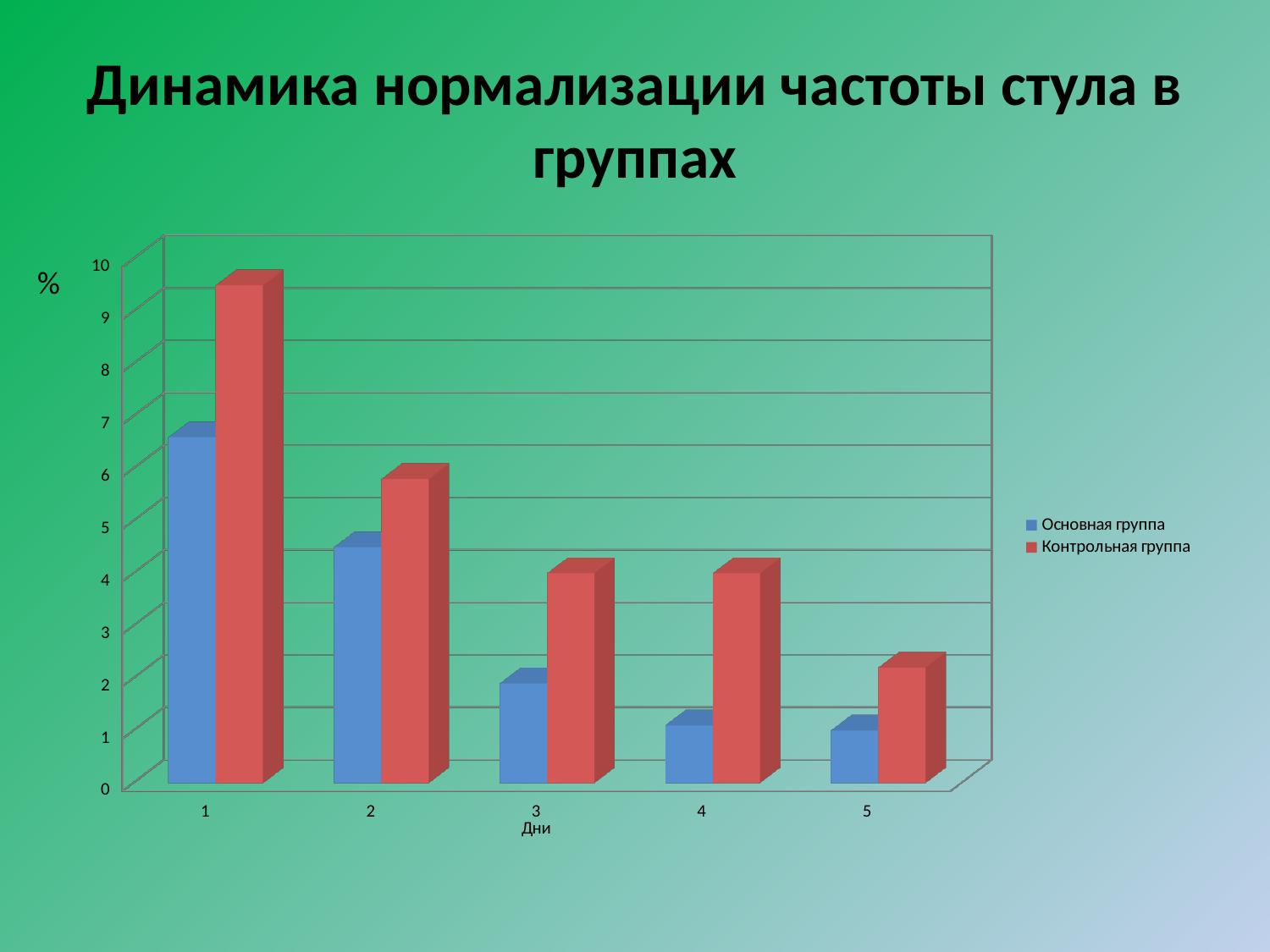
Is the value for Основная группа on day 3 greater or less than 3? less What is the title of the x axis? Дни Which series is shown in red in the legend? Контрольная группа On day 3, which series has the larger value, Основная группа or Контрольная группа? Контрольная группа What kind of chart is shown on the slide? bar chart How many series does the legend list? 2 Is the value for Контрольная группа on day 1 greater or less than 8? greater On which day is the value for Контрольная группа lowest? 5 Is the value for Основная группа on day 1 greater or less than 5? greater On which day is the value for Контрольная группа highest? 1 How many days (categories) are shown on the x axis? 5 Do the values for Контрольная группа rise or fall from day 1 to day 5? fall